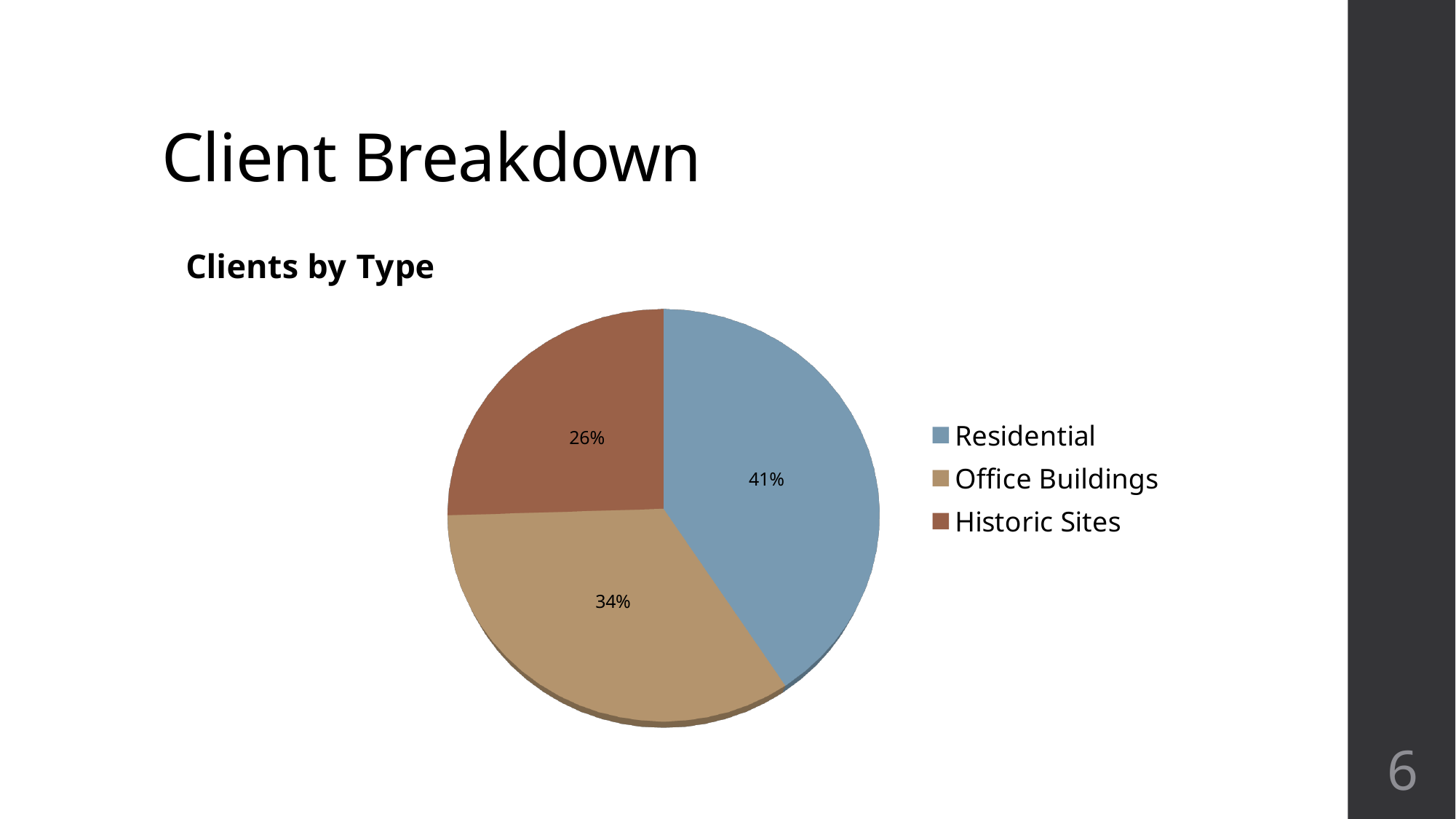
How many client types are shown in the pie chart? 3 What kind of chart is shown on the slide? Pie chart What is the difference in percentage points between the Residential and Historic Sites slices? 15 What share of the pie does Residential account for? 41% Which is larger, the Office Buildings slice or the Historic Sites slice? Office Buildings What is the title of the chart? Clients by Type Which client type has the smallest slice of the pie? Historic Sites What share of the pie does Office Buildings account for? 34% Which is larger, the Residential slice or the Office Buildings slice? Residential Which client type has the largest slice of the pie? Residential What is the difference in percentage points between the Office Buildings and Historic Sites slices? 8 What share of the pie does Historic Sites account for? 26%